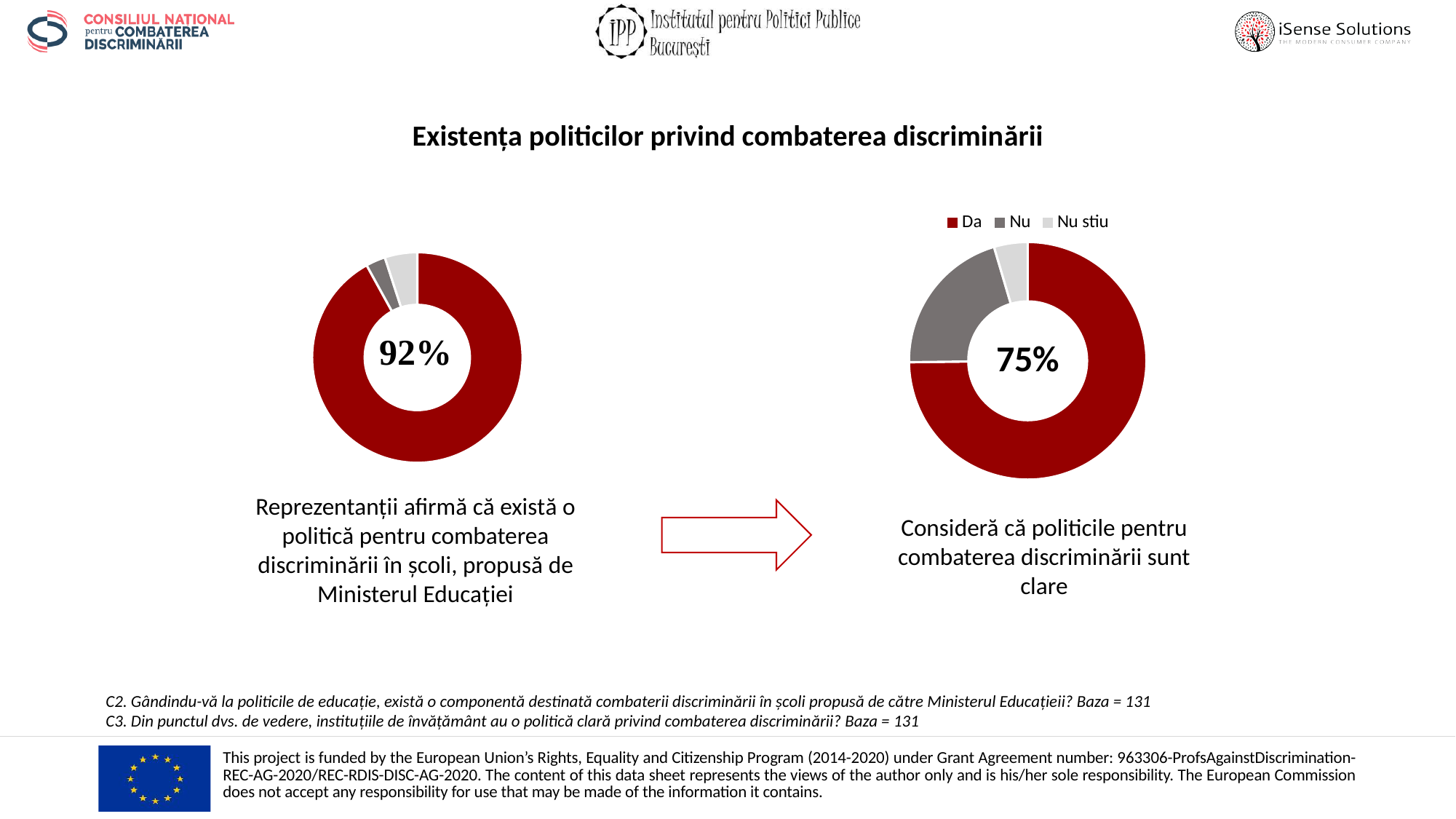
How many categories does the legend list? 3 In the right donut chart, what percentage is shown in the centre? 75% In the left donut chart, which category has the largest slice? Da In the left donut chart, what percentage is shown in the centre? 92% In the right donut chart, which is larger, the 'Nu' slice or the 'Nu stiu' slice? Nu How many slices does each donut chart have? 3 In the right donut chart, which category has the largest slice? Da What colour represents 'Da' in the legend? dark red Which chart shows the larger 'Da' share, the left chart (92%) or the right chart (75%)? the left chart What kind of chart is used on this slide to show the 92% and 75% results? donut (pie) chart What is the difference in percentage points between the 'Da' share in the left chart (92%) and the 'Da' share in the right chart (75%)? 17 percentage points What is the title of the slide above the charts? Existența politicilor privind combaterea discriminării